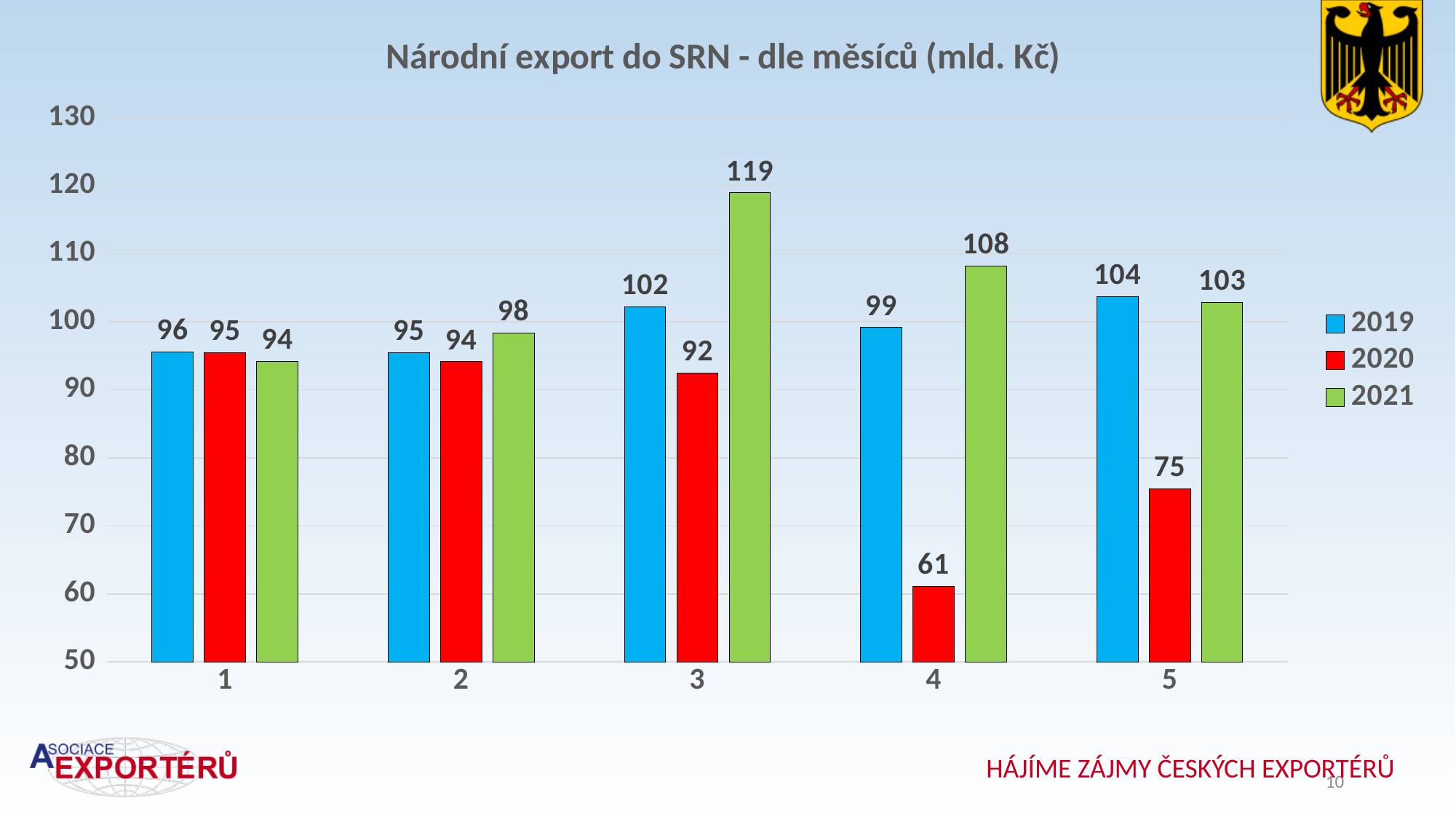
How many series does the legend list? 3 What is the difference between the 2021 and 2020 values in month 4? 47 Which is larger in month 5: the 2019 value or the 2021 value? 2019 What is the title of the chart? Národní export do SRN - dle měsíců (mld. Kč) What is the value for 2021 in month 3? 119 What is the value for 2019 in month 5? 104 Which month has the highest value for the 2021 series? 3 What kind of chart is shown on the slide? bar chart How many months are shown on the x axis? 5 Is the value for 2020 in month 5 greater or less than 80? less What is the value for 2020 in month 4? 61 Which month has the lowest value for the 2020 series? 4